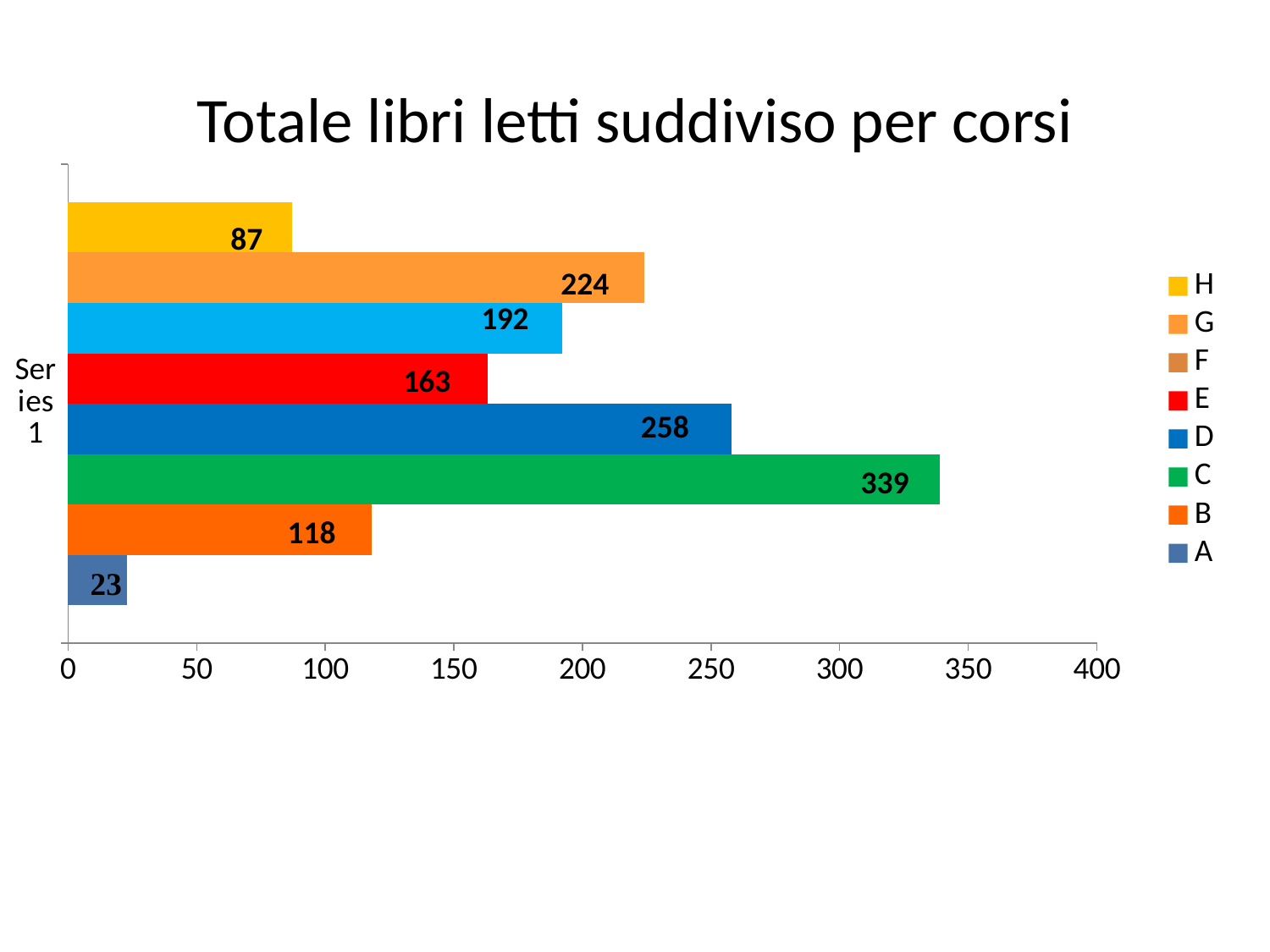
What is the title of the chart? Totale libri letti suddiviso per corsi What is the value for D? 258 What is the value for A? 23 What kind of chart is shown on the slide? bar chart How many bars are plotted on the chart? 8 What is the value for C? 339 What is the value for G? 224 Which category has the lowest value? A Which is larger, the value for B or the value for E? E Is the value for H greater or less than 100? less What is the difference between the values for C and D? 81 Which category has the highest value? C